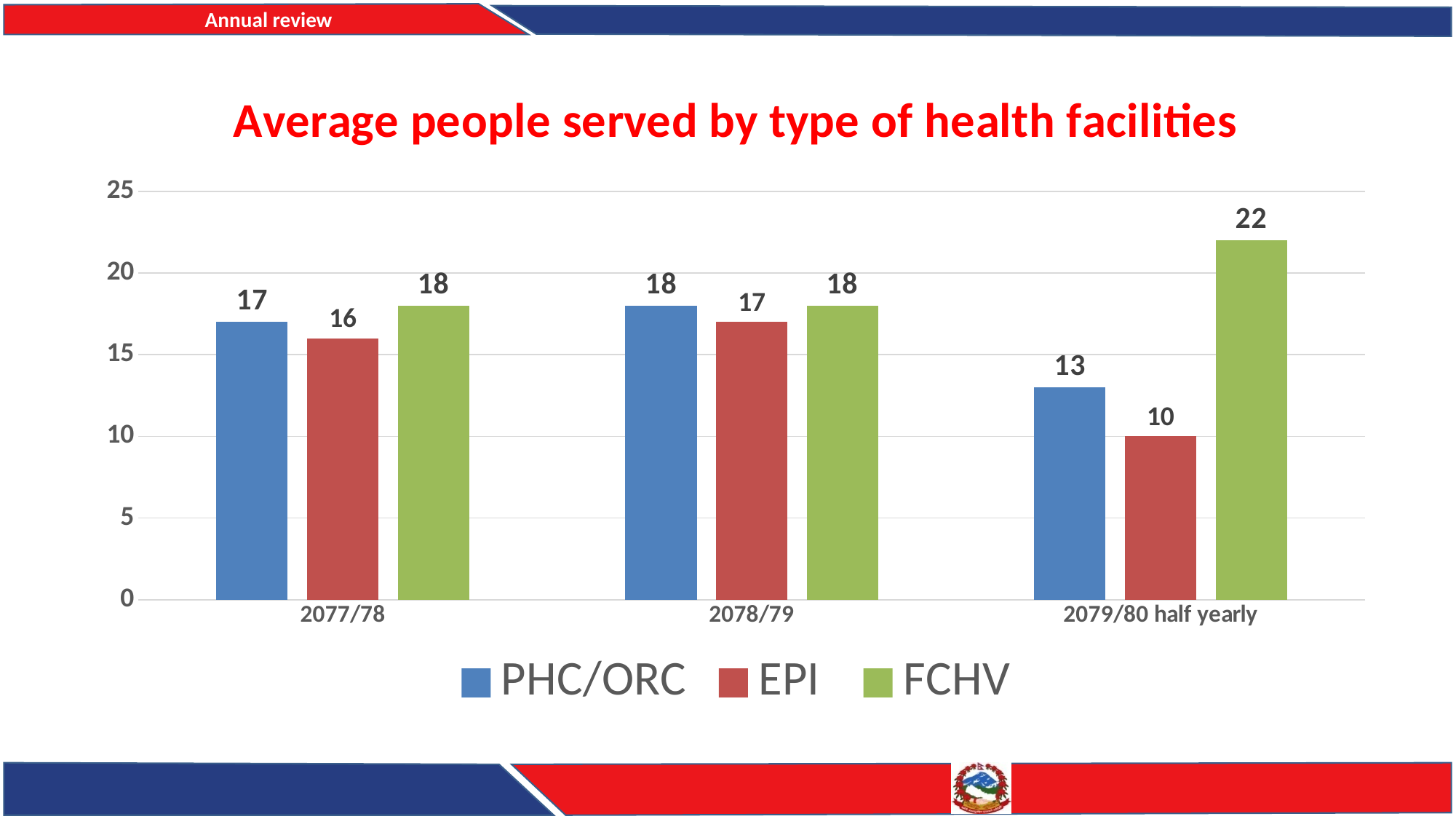
What is the value for EPI in 2077/78? 16 How many series does the legend list? 3 Which series has the highest value in 2079/80 half yearly? FCHV How many categories are shown on the x axis? 3 What kind of chart is shown on the slide? Bar chart What is the value for FCHV in 2079/80 half yearly? 22 Does the EPI value rise or fall from 2078/79 to 2079/80 half yearly? Fall What is the title of the chart? Average people served by type of health facilities Which series has the lowest value in 2079/80 half yearly? EPI What is the difference between the FCHV and EPI values in 2079/80 half yearly? 12 What is the value for PHC/ORC in 2078/79? 18 Which is larger, the PHC/ORC value in 2077/78 or the PHC/ORC value in 2079/80 half yearly? 2077/78